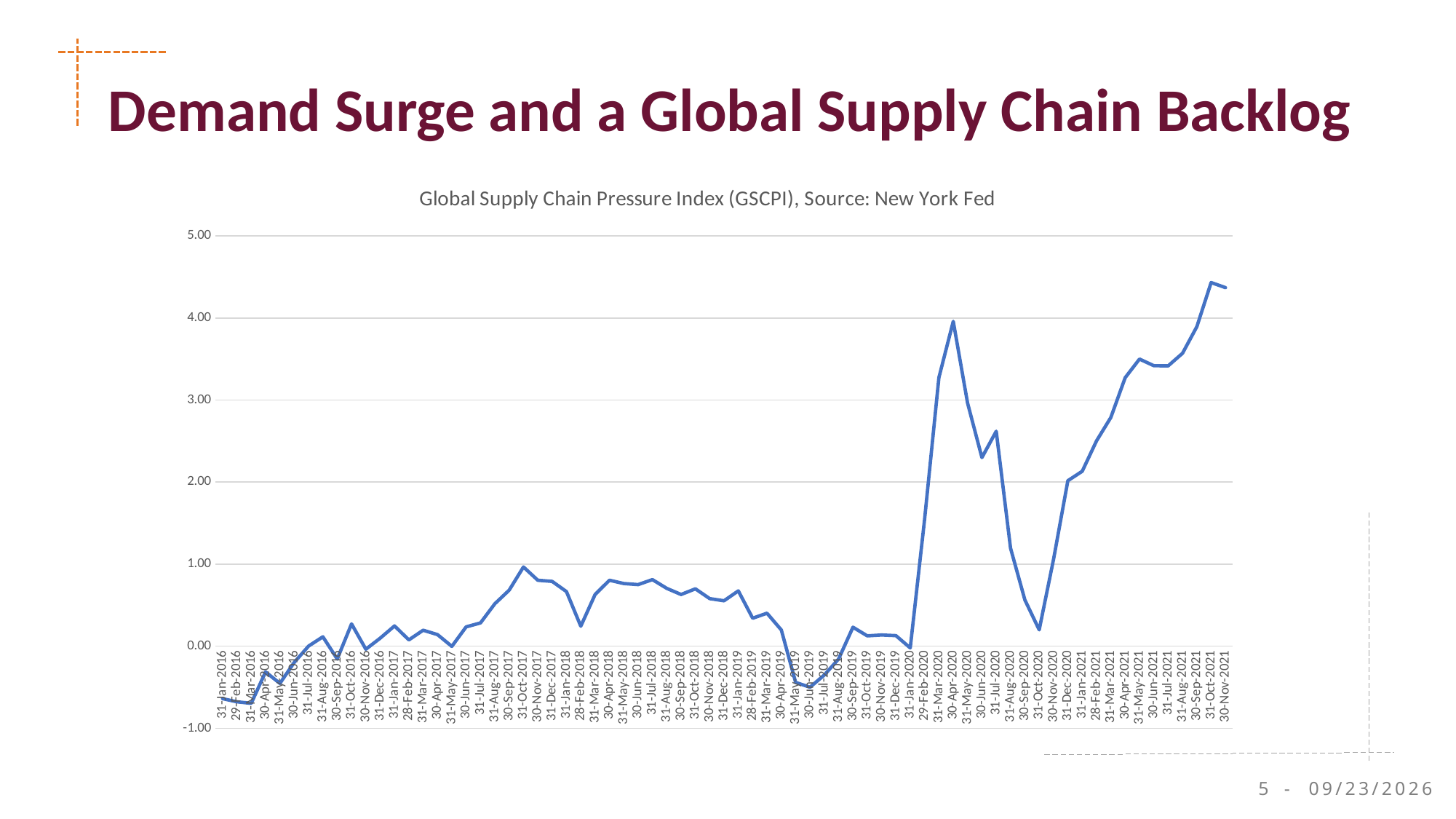
According to the chart title, what is the source of the data? New York Fed What is the title of the chart? Global Supply Chain Pressure Index (GSCPI), Source: New York Fed Is the value for 31-May-2021 greater or less than 3.00? greater Does the line rise or fall between 31-Jan-2020 and 30-Apr-2020? rise At which date does the line reach its highest value? 31-Oct-2021 What kind of chart is shown on the slide? line chart Is the value for 30-Jun-2019 greater or less than 0.00? less Is the value for 31-Jan-2020 greater or less than 1.00? less Which is larger, the value for 30-Apr-2020 or the value for 31-Oct-2021? 31-Oct-2021 Does the line rise or fall between 30-Apr-2020 and 31-Oct-2020? fall